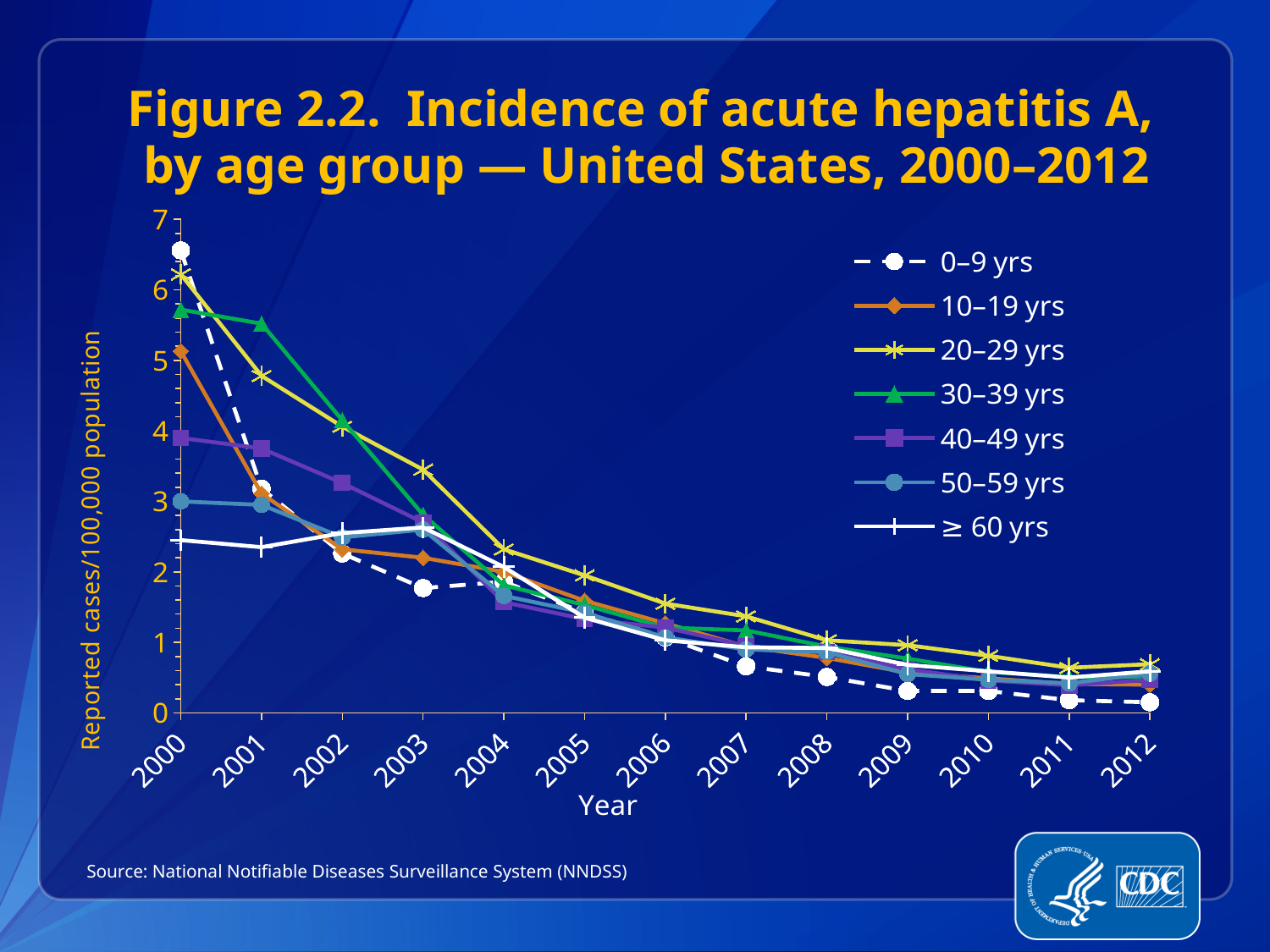
In 2000, which had the higher incidence: 30–39 yrs or 10–19 yrs? 30–39 yrs How many years are plotted along the x axis? 13 How many age-group series does the legend list? 7 Which age group had the lowest incidence in 2000? ≥ 60 yrs Is the value for 0–9 yrs in 2000 greater or less than 6? greater What is the label of the y axis? Reported cases/100,000 population Which age group had the highest incidence in 2000? 0–9 yrs Does the incidence for 0–9 yrs rise or fall from 2000 to 2012? Fall Is the value for 30–39 yrs in 2001 greater or less than 5? greater What kind of chart is shown on the slide? Line chart Which age group had the highest incidence in 2012? 20–29 yrs Is the value for ≥ 60 yrs in 2000 greater or less than 3? less